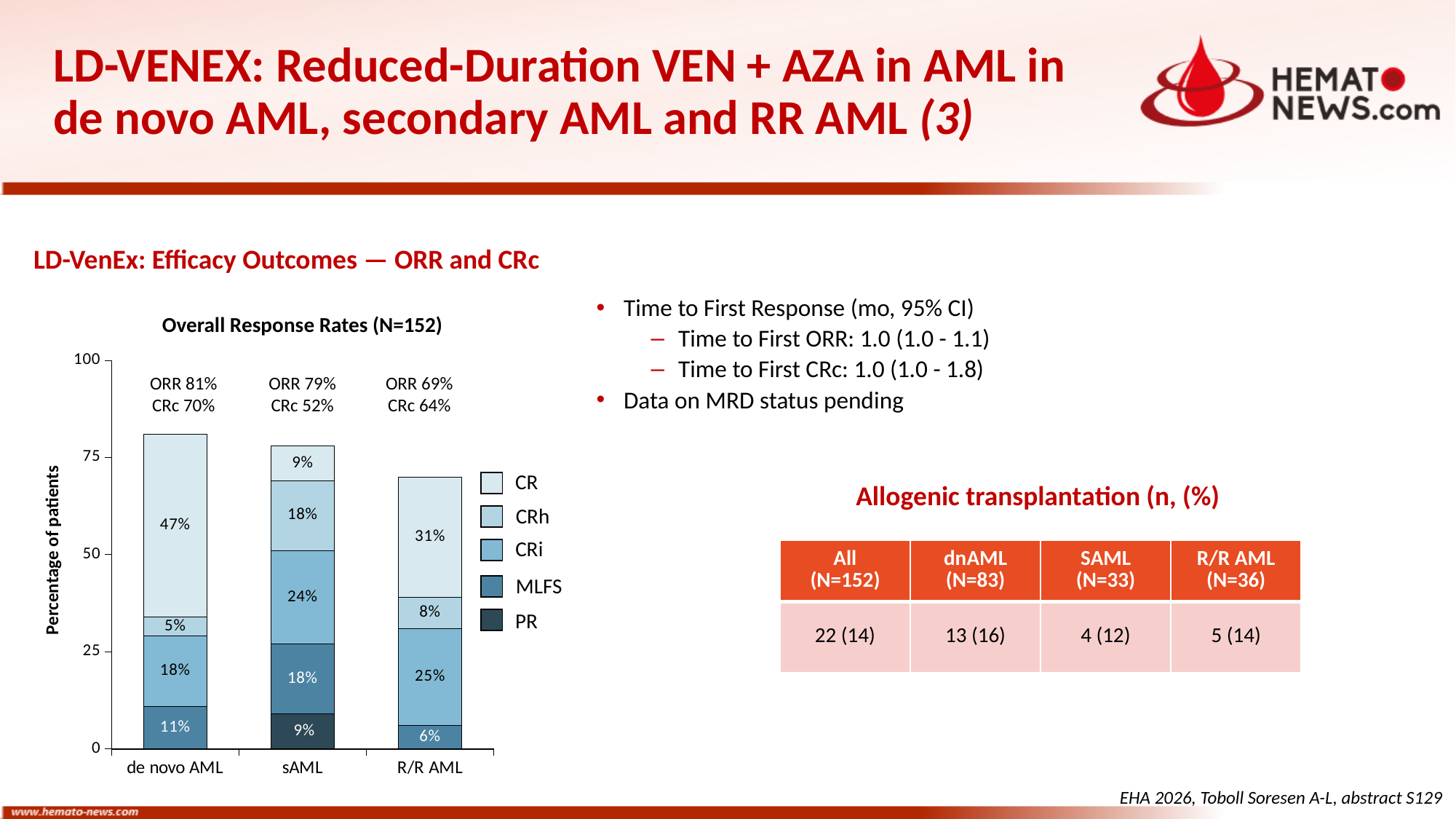
In the Overall Response Rates chart, what is the CRh percentage for R/R AML? 8% What kind of chart is shown under the title "Overall Response Rates (N=152)"? Stacked bar chart How many series does the legend of the Overall Response Rates chart list? 5 In the Overall Response Rates chart, what ORR is labelled above the R/R AML bar? ORR 69% In the Overall Response Rates chart, what CRc is labelled above the sAML bar? CRc 52% In the Overall Response Rates chart, what is the CRi percentage for sAML? 24% In the Overall Response Rates chart, by how many percentage points does the ORR for de novo AML exceed the ORR for R/R AML? 12 percentage points In the Overall Response Rates chart, which group has the larger CR segment, de novo AML or R/R AML? de novo AML How many patient groups are plotted on the x axis of the Overall Response Rates chart? 3 In the Overall Response Rates chart, which patient group has the highest ORR? de novo AML In the Overall Response Rates chart, which patient group has the lowest CRc? sAML In the Overall Response Rates chart, what is the CR percentage for de novo AML? 47%